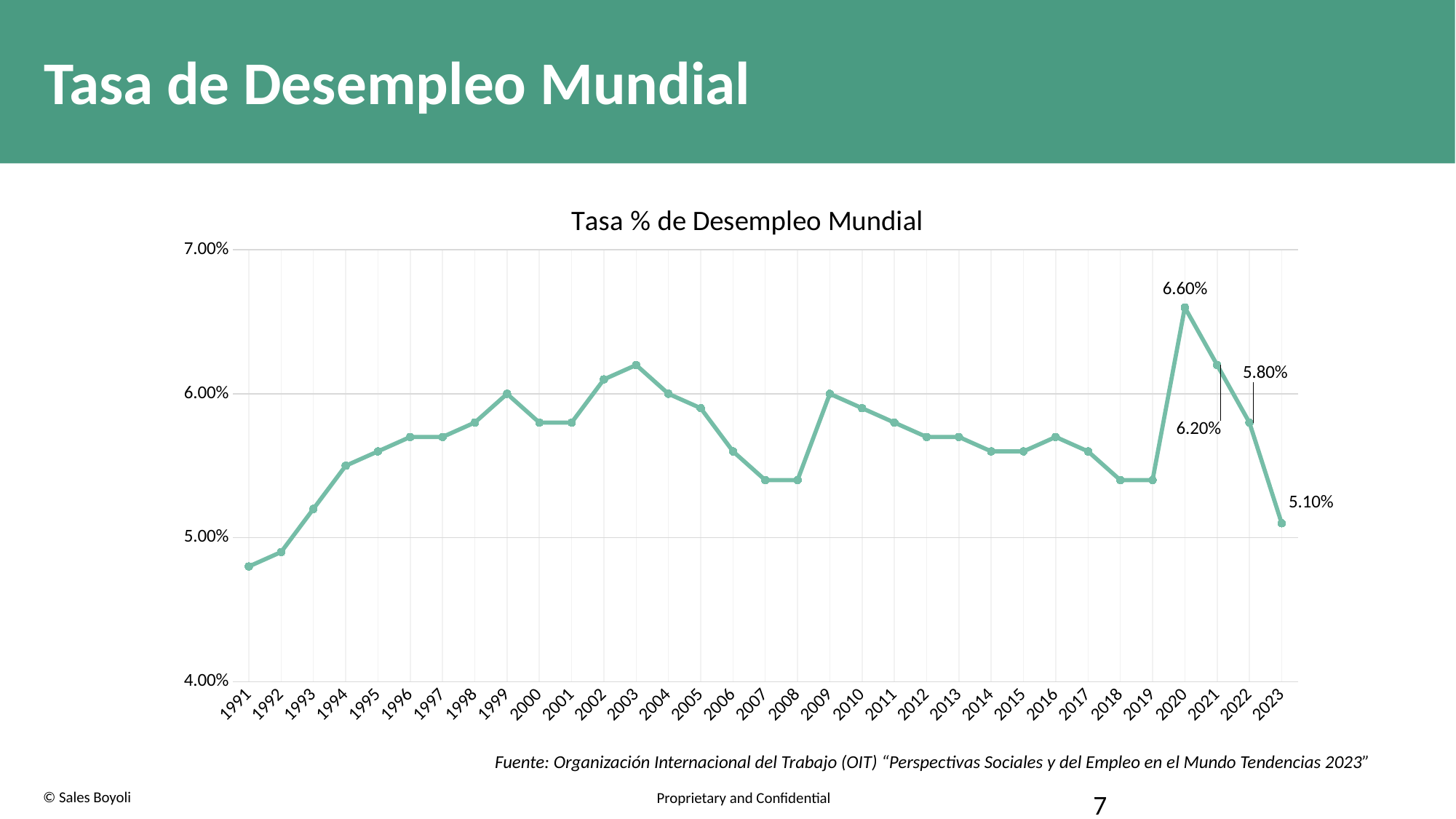
How many years are plotted on the x axis? 33 Is the value for 2003 greater or less than 6.00%? greater What is the value for 2022? 5.80% Is the value for 1991 greater or less than 5.00%? less What is the difference between the values for 2020 and 2023? 1.50% What is the value for 2023? 5.10% What is the value for 2021? 6.20% What kind of chart is shown? line chart Which year has the lowest unemployment rate? 1991 Which year has the highest unemployment rate? 2020 Which is larger, the value for 2020 or the value for 2022? 2020 What is the value for 2020? 6.60%